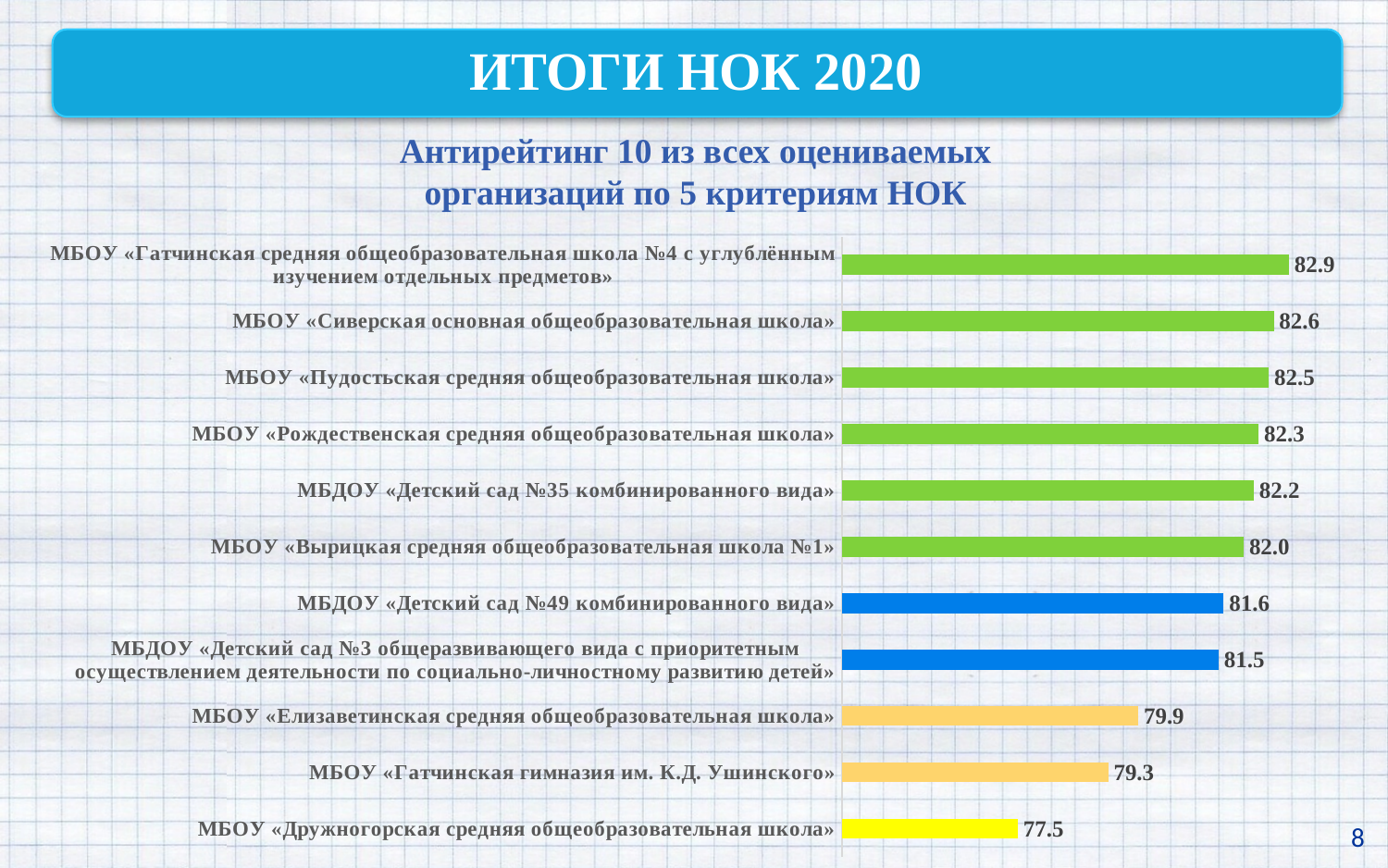
What is the value for МБОУ «Сиверская основная общеобразовательная школа»? 82.6 What is the value for МБДОУ «Детский сад №49 комбинированного вида»? 81.6 What is the difference between the values for МБОУ «Пудостьская средняя общеобразовательная школа» and МБДОУ «Детский сад №3 общеразвивающего вида с приоритетным осуществлением деятельности по социально-личностному развитию детей»? 1.0 Which organization has the highest value on the chart? МБОУ «Гатчинская средняя общеобразовательная школа №4 с углублённым изучением отдельных предметов» Which organization has the lowest value on the chart? МБОУ «Дружногорская средняя общеобразовательная школа» What is the difference between the values for МБОУ «Елизаветинская средняя общеобразовательная школа» and МБОУ «Дружногорская средняя общеобразовательная школа»? 2.4 How many organizations are shown on the chart? 11 What colour is the bar for МБОУ «Дружногорская средняя общеобразовательная школа»? yellow Which has a larger value: МБОУ «Рождественская средняя общеобразовательная школа» or МБОУ «Елизаветинская средняя общеобразовательная школа»? МБОУ «Рождественская средняя общеобразовательная школа» What is the value for МБОУ «Дружногорская средняя общеобразовательная школа»? 77.5 What type of chart is shown on the slide? bar chart What is the value for МБОУ «Гатчинская гимназия им. К.Д. Ушинского»? 79.3